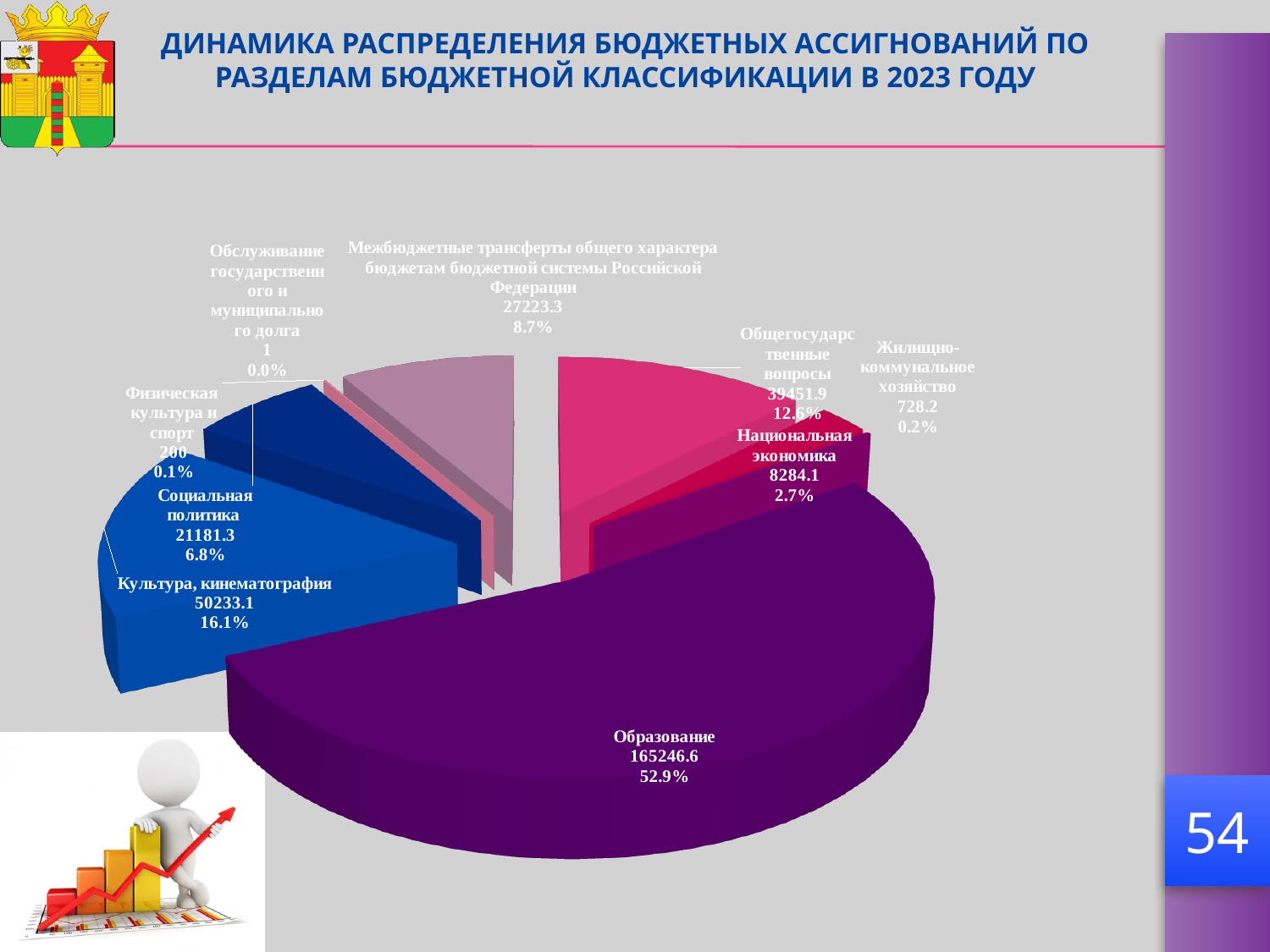
Which category has the largest slice of the pie? Образование How many categories (slices) does the pie chart show? 9 What is the value shown for Общегосударственные вопросы? 39451.9 What is the value shown for Культура, кинематография? 50233.1 What share of the pie does Социальная политика represent? 6.8% What share of the pie does Национальная экономика represent? 2.7% What is the difference between the values for Жилищно-коммунальное хозяйство and Физическая культура и спорт? 528.2 Which is larger, the value for Социальная политика or the value for Межбюджетные трансферты общего характера бюджетам бюджетной системы Российской Федерации? Межбюджетные трансферты общего характера бюджетам бюджетной системы Российской Федерации What is the title of the slide containing the pie chart? ДИНАМИКА РАСПРЕДЕЛЕНИЯ БЮДЖЕТНЫХ АССИГНОВАНИЙ ПО РАЗДЕЛАМ БЮДЖЕТНОЙ КЛАССИФИКАЦИИ В 2023 ГОДУ What kind of chart is shown on the slide? Pie chart What is the value shown for Образование? 165246.6 Which category has the smallest value in the pie chart? Обслуживание государственного и муниципального долга